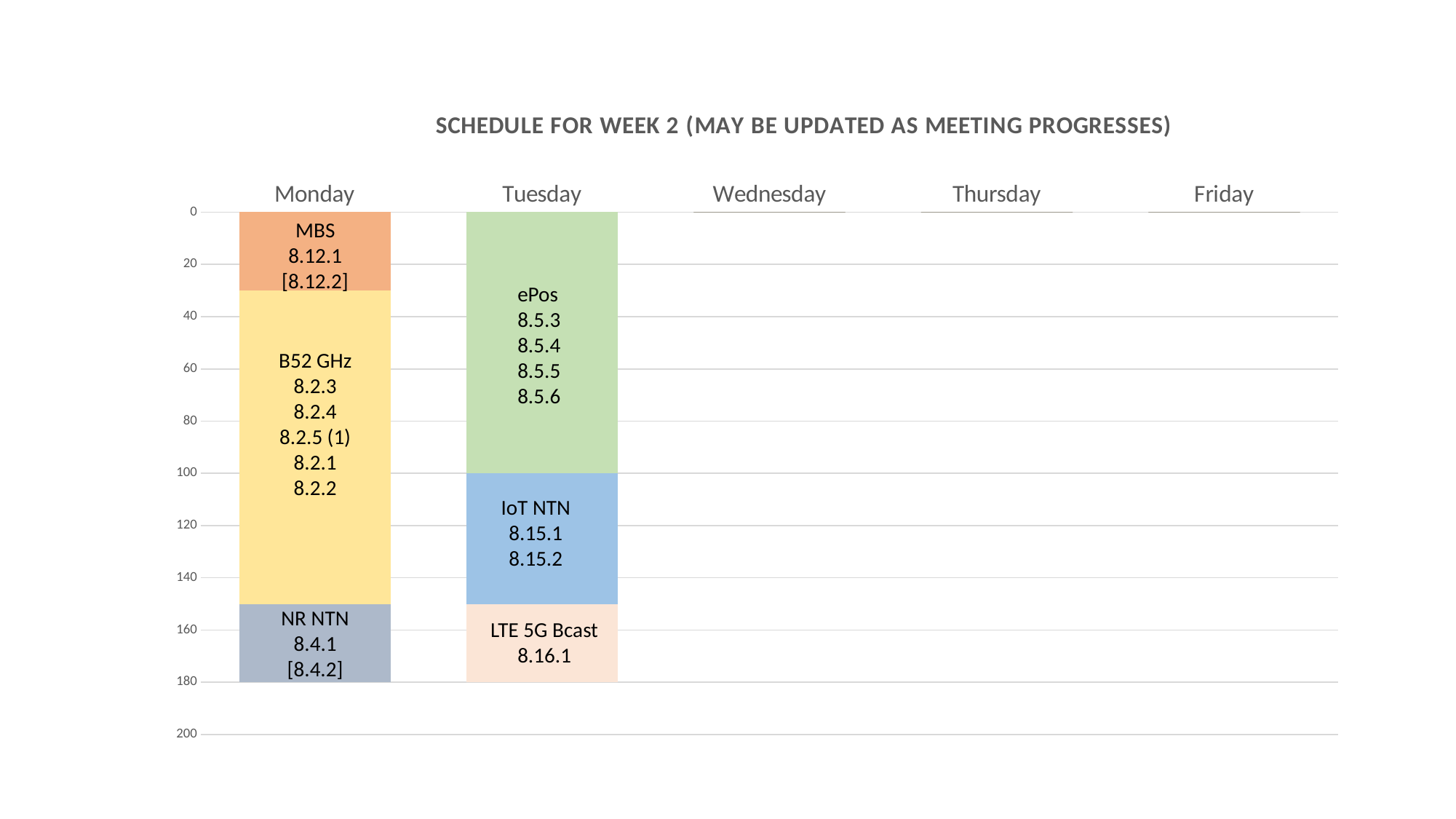
Which segment of the Tuesday bar is the largest? ePos Which is larger, the ePos segment or the IoT NTN segment? ePos How many segments make up the Monday bar? 3 At what axis value does the Monday bar end? 180 At what axis value does the ePos segment of the Tuesday bar end? 100 Is the length of the B52 GHz segment greater or less than 100? greater How many day categories are shown along the x axis? 5 What kind of chart is shown on the slide? Stacked bar chart What is the title of the chart? SCHEDULE FOR WEEK 2 (MAY BE UPDATED AS MEETING PROGRESSES) Which segment of the Monday bar is the largest? B52 GHz How many days have a bar plotted? 2 At what axis value does the Tuesday bar end? 180